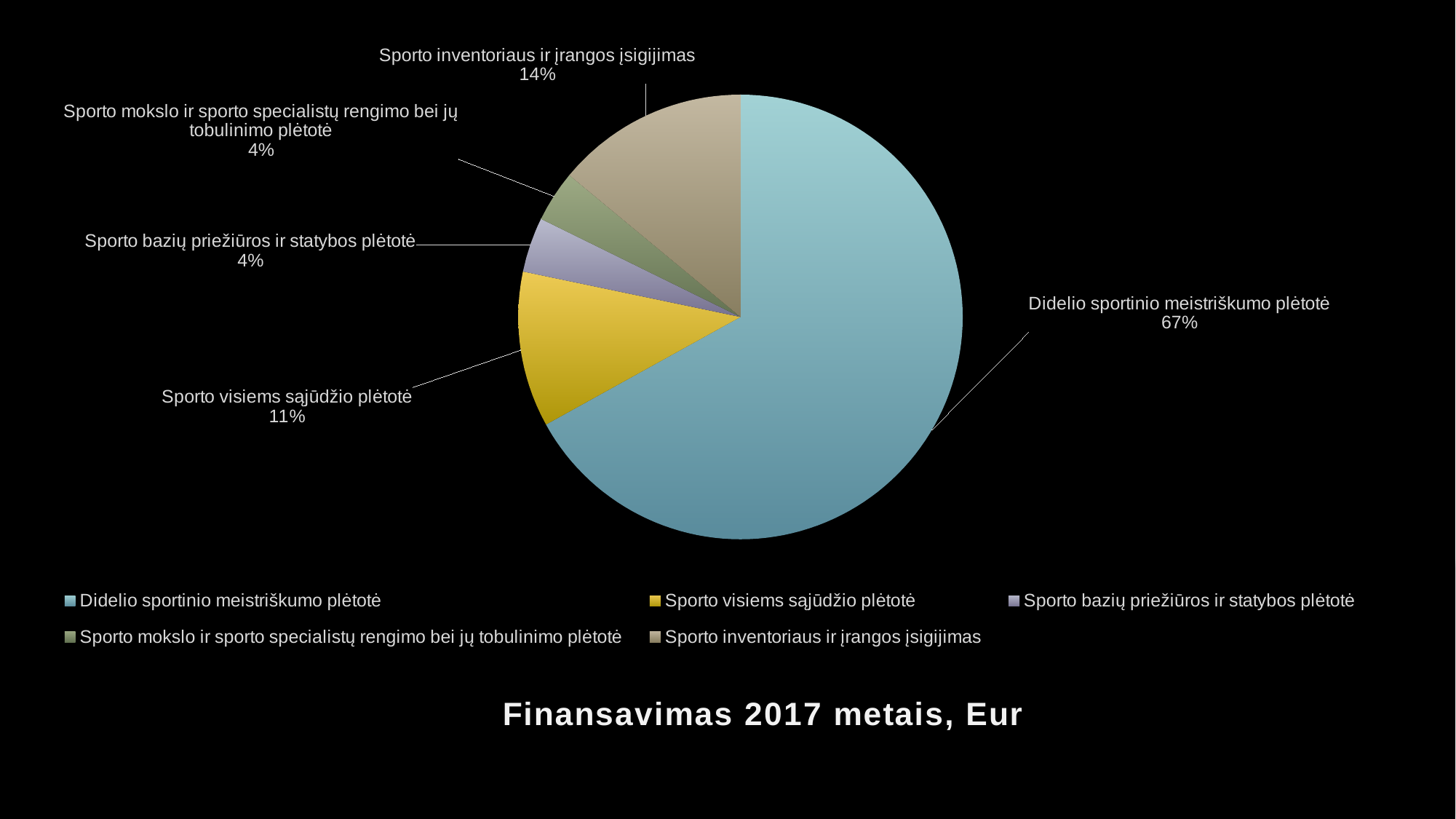
What kind of chart is shown on the slide? pie chart What share of the pie does "Sporto visiems sąjūdžio plėtotė" take? 11% What share of the pie does "Sporto bazių priežiūros ir statybos plėtotė" take? 4% How many entries does the legend list? 5 What is the title of the chart? Finansavimas 2017 metais, Eur What share of the pie does "Didelio sportinio meistriškumo plėtotė" take? 67% What colour is the slice for "Sporto visiems sąjūdžio plėtotė"? yellow How many slices does the pie chart have? 5 What is the difference in percentage points between "Didelio sportinio meistriškumo plėtotė" and "Sporto inventoriaus ir įrangos įsigijimas"? 53 Which is larger: the share for "Sporto inventoriaus ir įrangos įsigijimas" or for "Sporto visiems sąjūdžio plėtotė"? Sporto inventoriaus ir įrangos įsigijimas Which category has the largest slice of the pie? Didelio sportinio meistriškumo plėtotė